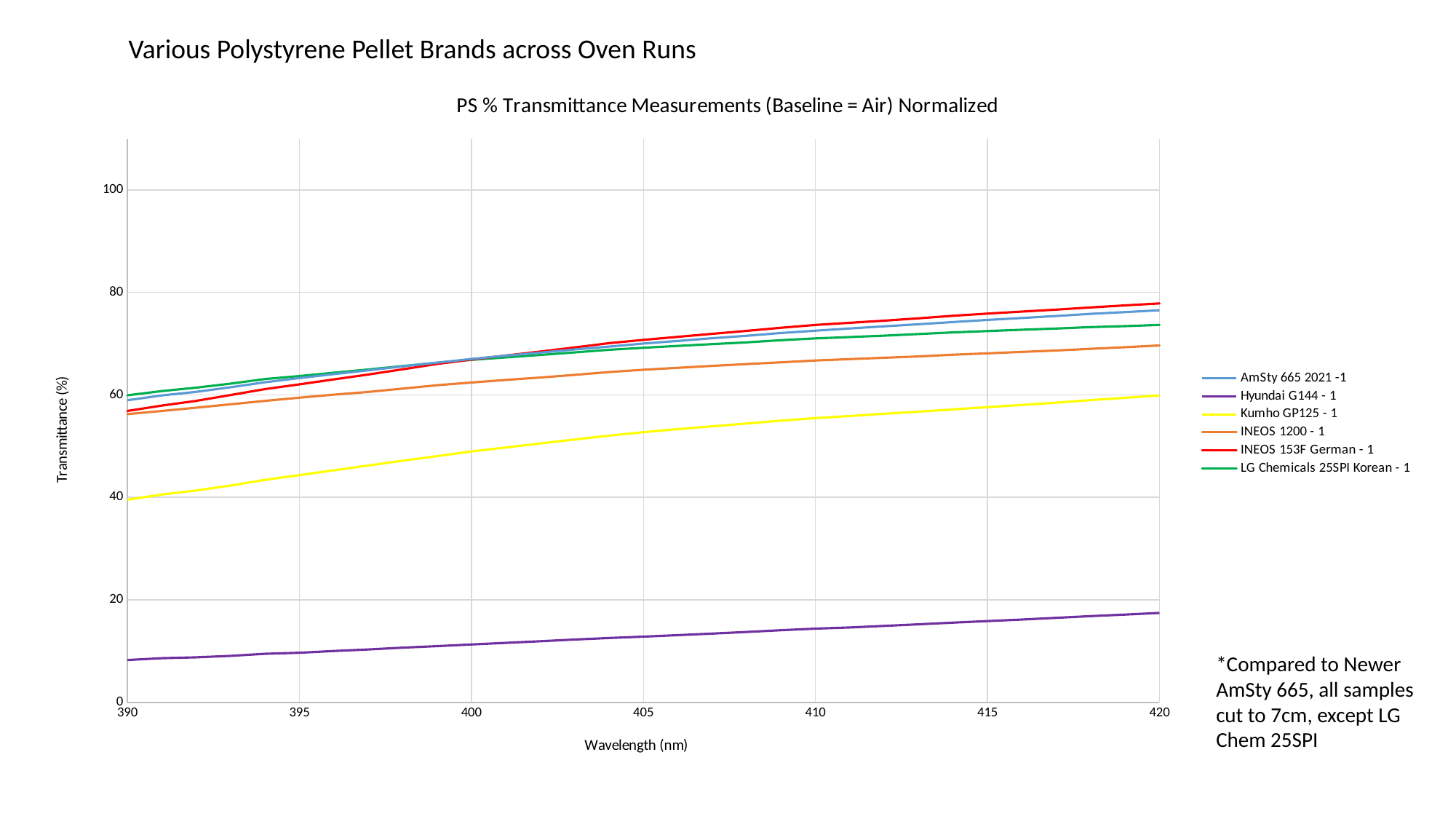
At 410 nm, which has the higher transmittance: Kumho GP125 - 1 or INEOS 1200 - 1? INEOS 1200 - 1 Does the transmittance for Kumho GP125 - 1 rise or fall as wavelength increases from 390 to 420 nm? rise What is the title of the chart? PS % Transmittance Measurements (Baseline = Air) Normalized Is the value for Hyundai G144 - 1 at 420 nm greater or less than 20? less Is the value for INEOS 153F German - 1 at 420 nm greater or less than 80? less What kind of chart is shown on the slide? line chart What is the label of the x axis? Wavelength (nm) Does the transmittance for Hyundai G144 - 1 rise or fall from 390 to 420 nm? rise How many series does the legend list? 6 Which series has the lowest transmittance across the whole wavelength range? Hyundai G144 - 1 Is the value for INEOS 1200 - 1 at 420 nm greater or less than 60? greater